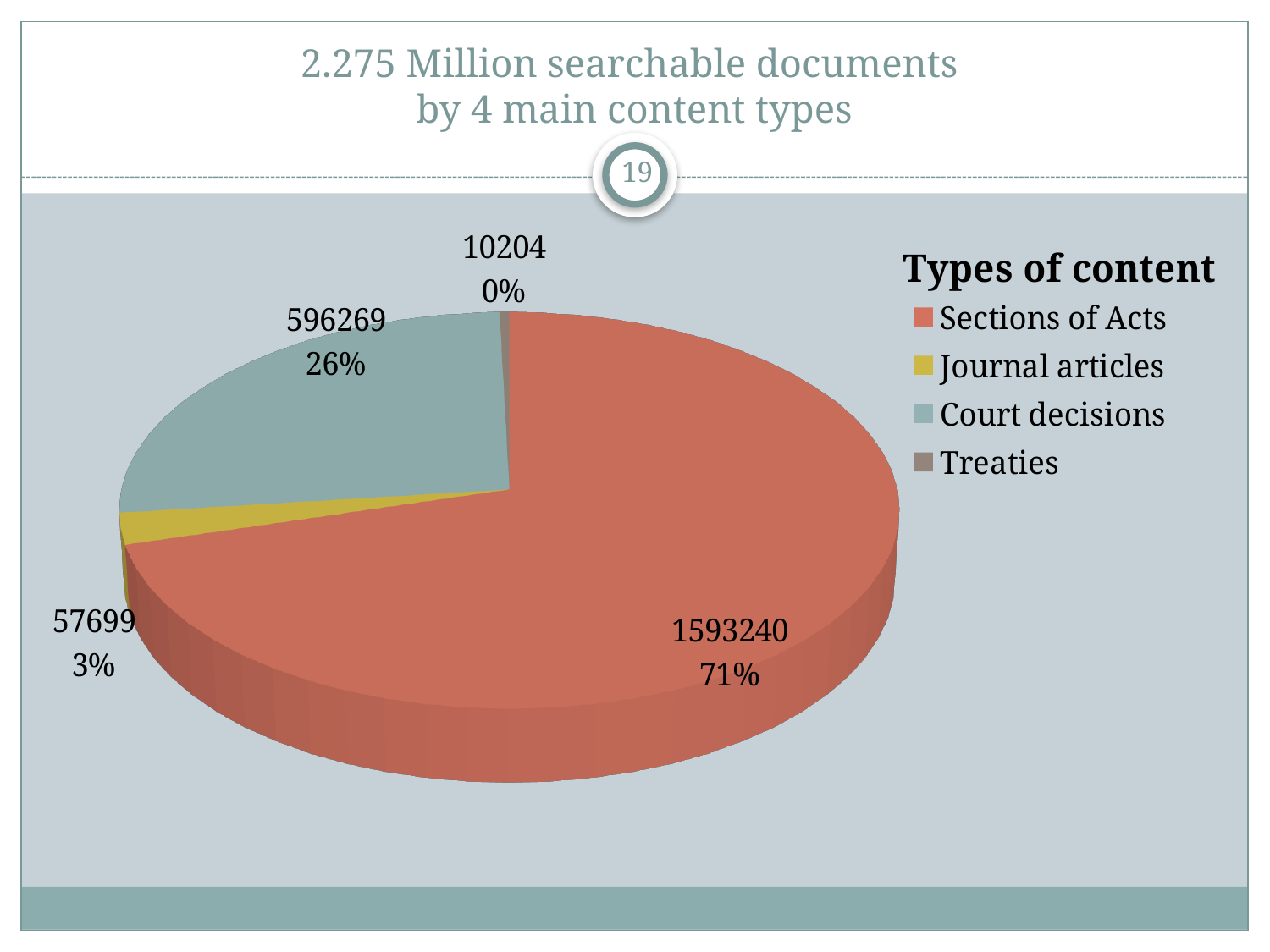
Which content type has the largest slice? Sections of Acts How many slices does the pie chart have? 4 What share of the pie do Court decisions represent? 26% Which content type has the smallest slice? Treaties What is the value for Journal articles? 57699 What is the value for Court decisions? 596269 What share of the pie do Sections of Acts represent? 71% What is the difference between the values for Court decisions and Journal articles? 538570 What is the value for Sections of Acts? 1593240 What is the value for Treaties? 10204 How many entries does the legend list? 4 What kind of chart is shown on the slide? Pie chart